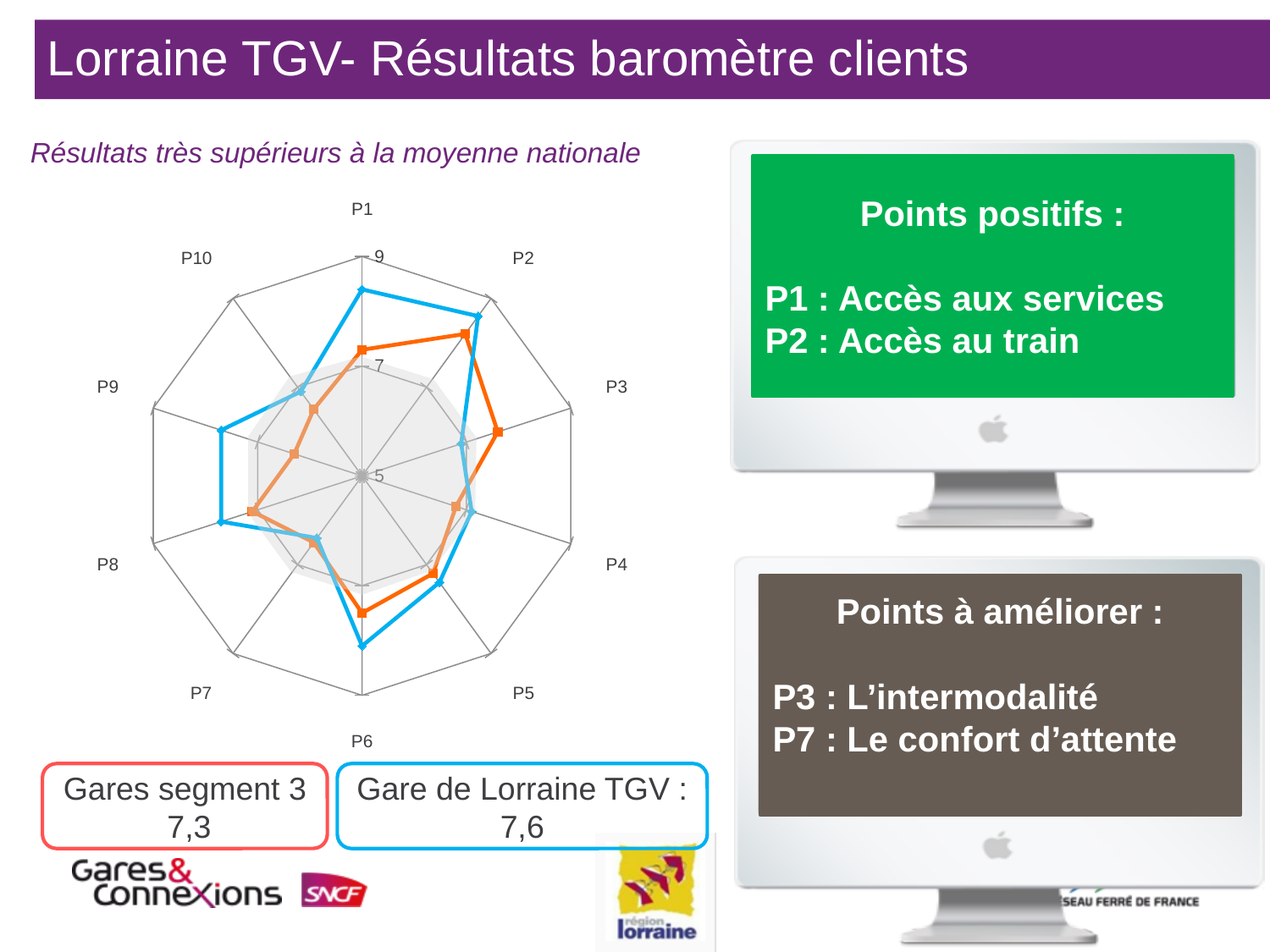
At P3, which series has the higher value, the blue or the orange one? Orange Is the value of the orange series for P2 greater or less than 7? greater Which tick values are labelled on the radar chart's scale? 5, 7 and 9 How many data series are plotted on the radar chart? 2 What kind of chart is shown on the slide? Radar chart Is the value of the blue series for P9 greater or less than 7? greater Is the value of the blue series for P1 greater or less than 7? greater At P9, which series has the higher value, the blue or the orange one? Blue At P1, which series has the higher value, the blue or the orange one? Blue How many categories (axes) does the radar chart have? 10